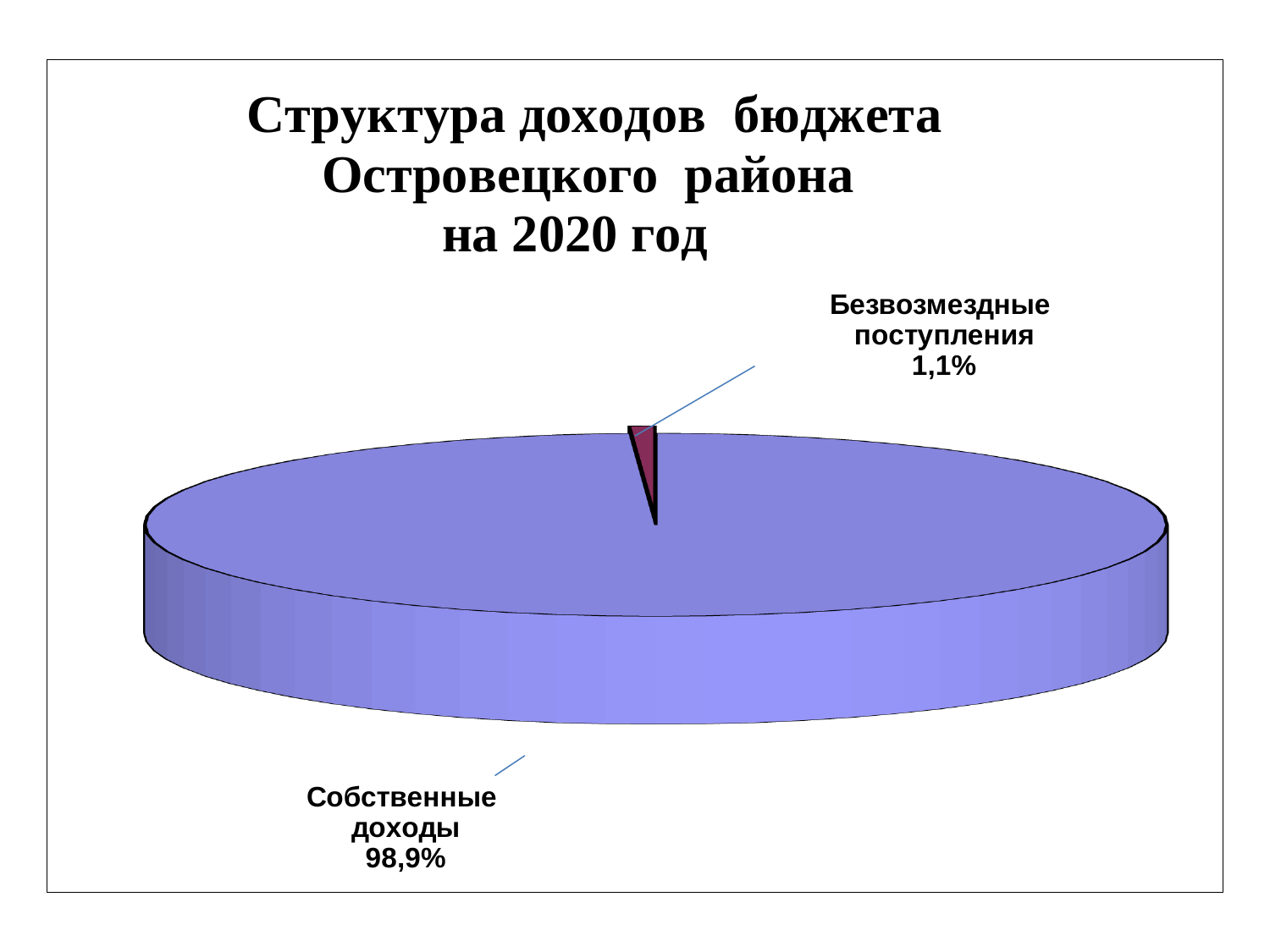
What is the difference in percentage points between Собственные доходы and Безвозмездные поступления? 97,8 How many slices does the pie chart have? 2 What is the share of Безвозмездные поступления in the pie chart? 1,1% What is the total of the two slice percentages shown in the pie chart? 100% Which slice of the pie chart is the smallest? Безвозмездные поступления What kind of chart is shown on the slide? pie chart What colour is the Безвозмездные поступления slice? dark red What is the title of the chart? Структура доходов бюджета Островецкого района на 2020 год What is the share of Собственные доходы in the pie chart? 98,9% Which slice of the pie chart is the largest? Собственные доходы Which is larger: Собственные доходы or Безвозмездные поступления? Собственные доходы